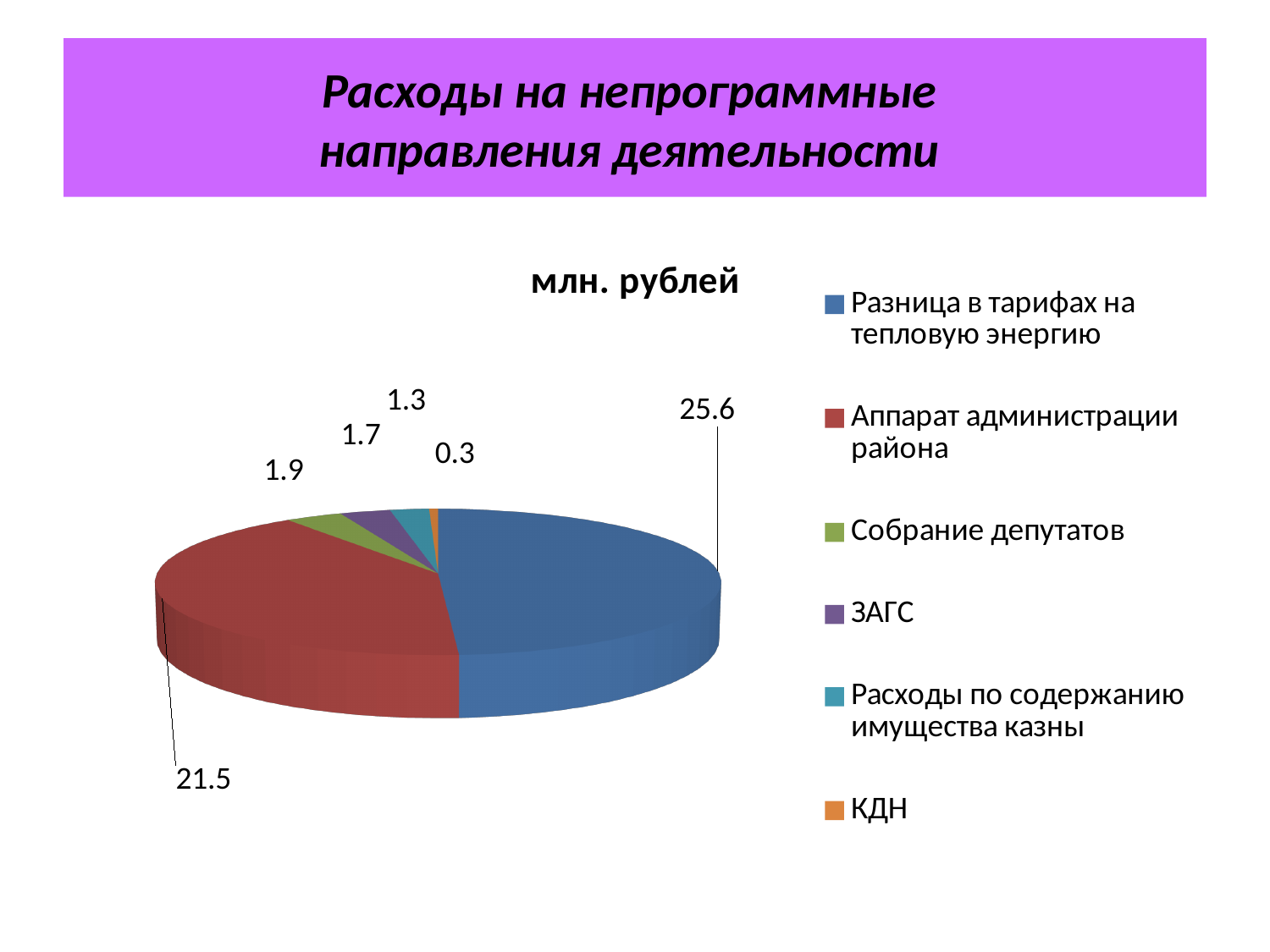
Which is larger, the value for Собрание депутатов or the value for ЗАГС? Собрание депутатов Which category has the largest slice of the pie? Разница в тарифах на тепловую энергию What is the value for Аппарат администрации района? 21.5 What kind of chart is shown on the slide? Pie chart Which category has the smallest slice of the pie? КДН What is the value for Разница в тарифах на тепловую энергию? 25.6 How many categories does the legend list? 6 What is the value for ЗАГС? 1.7 What is the value for Собрание депутатов? 1.9 What is the value for КДН? 0.3 What is the difference between the values for Разница в тарифах на тепловую энергию and Аппарат администрации района? 4.1 What is the value for Расходы по содержанию имущества казны? 1.3